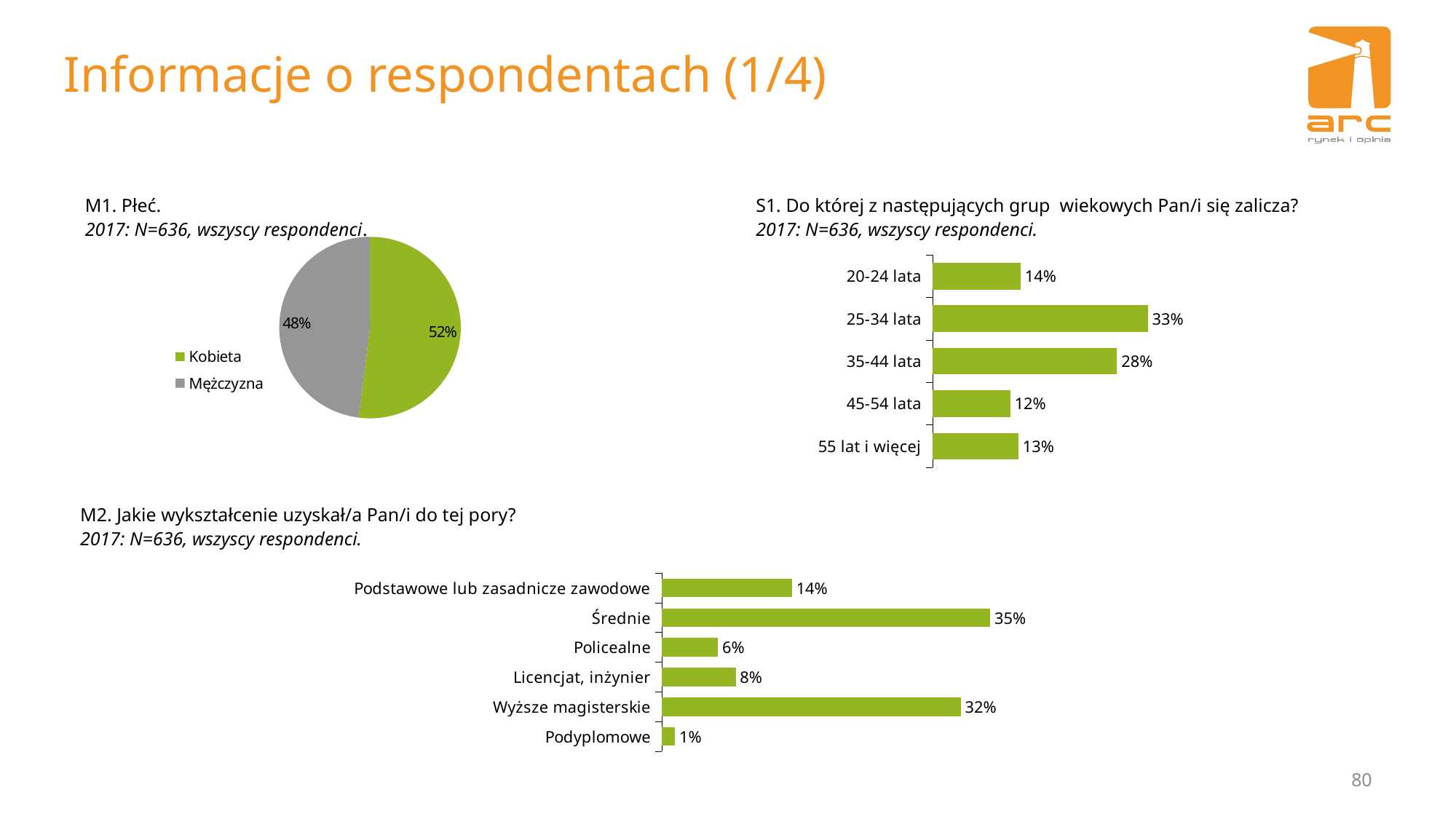
In the S1 age group chart, what is the value for 25-34 lata? 33% In the S1 age group chart, which age group has the highest value? 25-34 lata In the S1 age group chart, what is the difference between 25-34 lata and 35-44 lata? 5 percentage points How many age groups are shown in the S1 chart? 5 In the S1 age group chart, which age group has the lowest value? 45-54 lata In the M2 education chart, what is the value for Wyższe magisterskie? 32% In the M1. Płeć pie chart, what share of respondents are Mężczyzna? 48% In the M2 education chart, which is larger: Średnie or Wyższe magisterskie? Średnie In the M1. Płeć pie chart, what share of respondents are Kobieta? 52% In the M2 education chart, which category has the lowest value? Podyplomowe What kind of chart is the M1. Płeć chart? pie chart How many categories are shown in the M2 education chart? 6